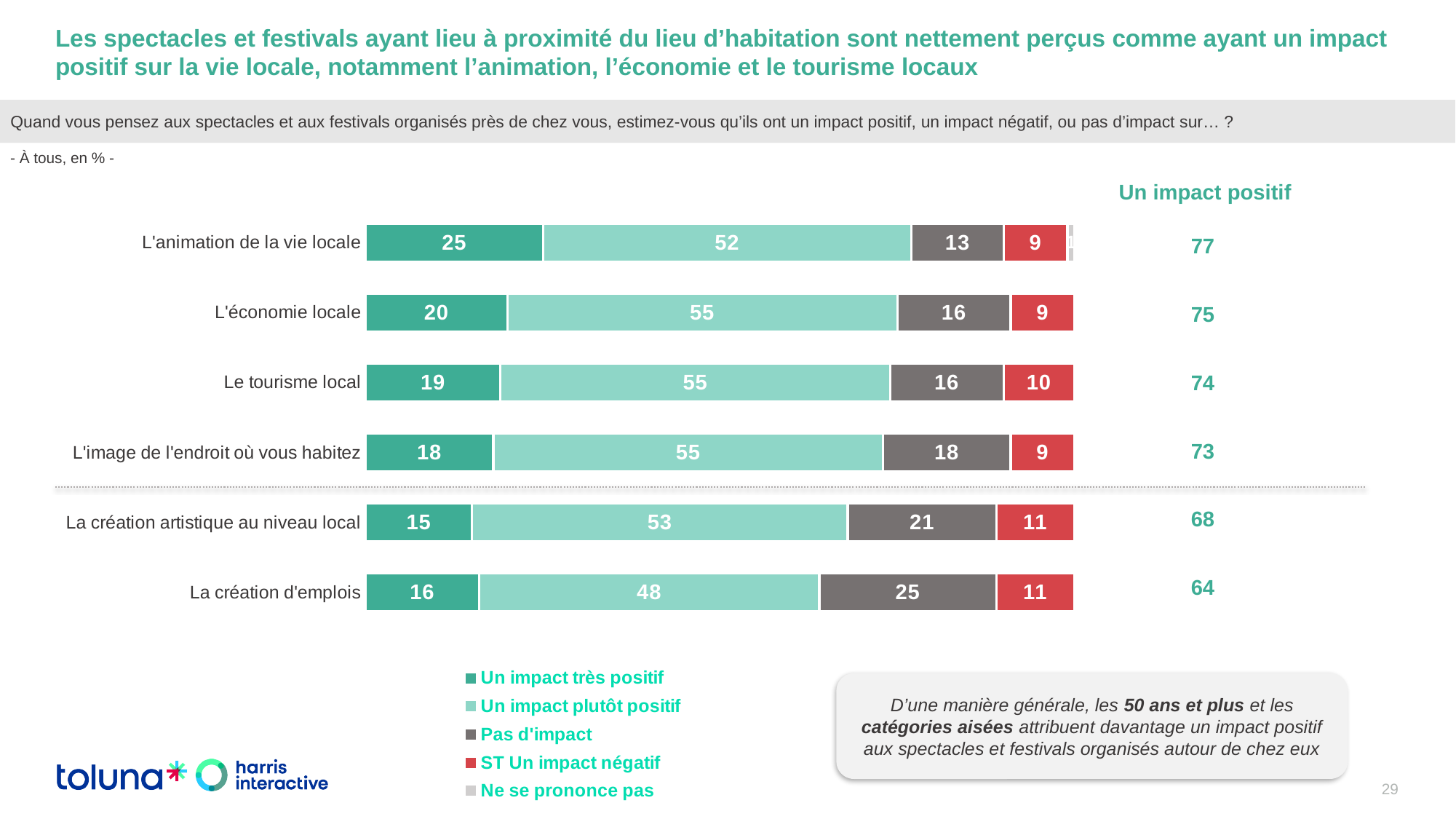
Which has the larger "Pas d'impact" value: La création artistique au niveau local or L'économie locale? La création artistique au niveau local What is the combined total of "Un impact très positif" and "Un impact plutôt positif" for L'image de l'endroit où vous habitez? 73 Which category has the highest "Un impact positif" figure? L'animation de la vie locale How many categories are shown in the chart? 6 What is the value for "Un impact très positif" for L'animation de la vie locale? 25 What is the "Un impact positif" figure shown for L'économie locale? 75 What is the difference between the "Un impact plutôt positif" values for L'économie locale and La création d'emplois? 7 How many series does the legend list? 5 What kind of chart is shown on the slide? Stacked bar chart What is the value for "Pas d'impact" for La création d'emplois? 25 Which category has the lowest "Un impact positif" figure? La création d'emplois What is the value for "ST Un impact négatif" for Le tourisme local? 10